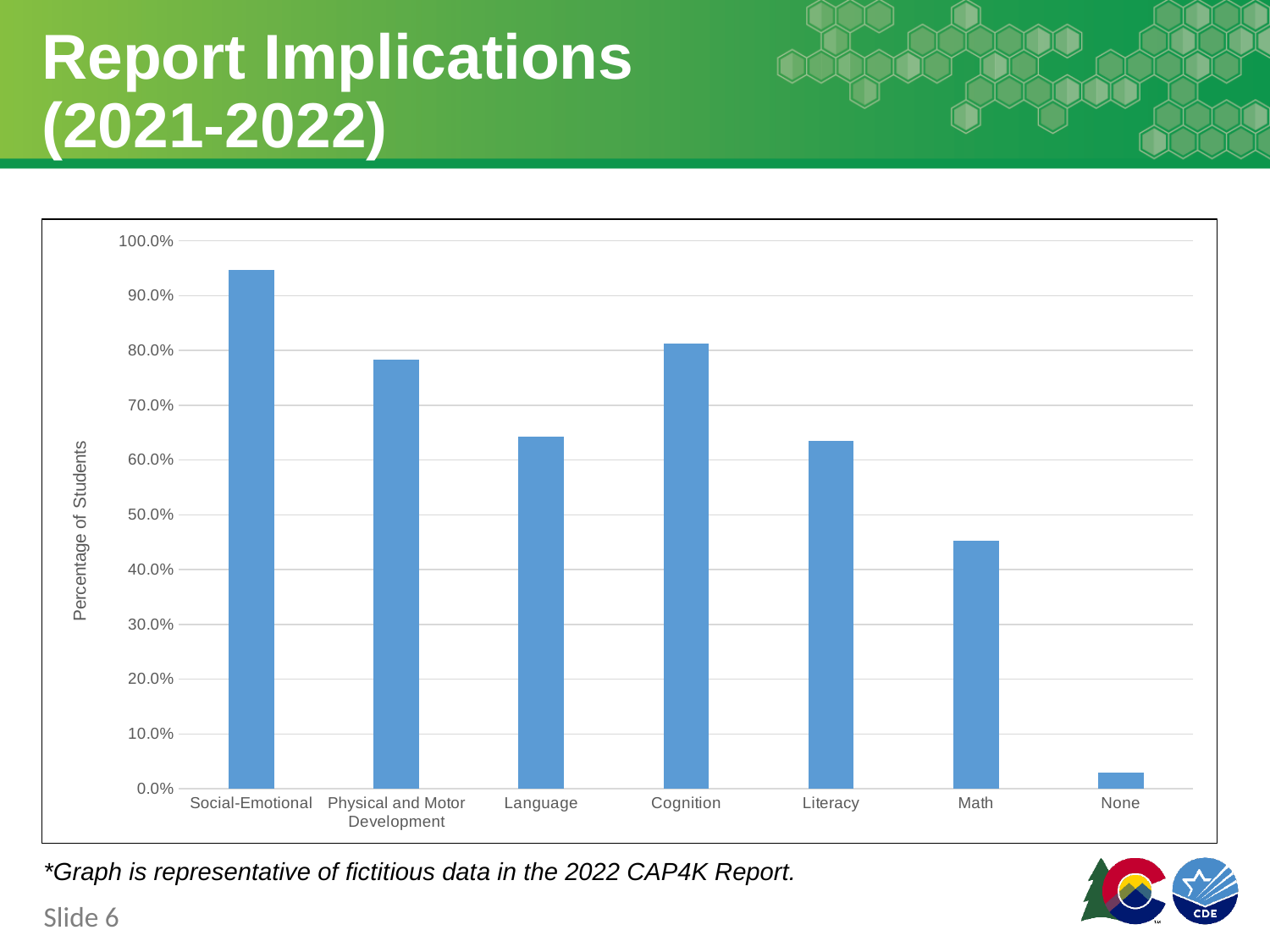
Is the value for Social-Emotional greater or less than 90.0%? greater Which category has the highest percentage of students? Social-Emotional Is the value for Cognition greater or less than 80.0%? greater Is the value for None greater or less than 10.0%? less Which has a higher percentage of students, Math or Language? Language Which category has the lowest percentage of students? None What is the label on the vertical axis of the chart? Percentage of Students Which has a higher percentage of students, Cognition or Physical and Motor Development? Cognition What kind of chart is shown on the slide? bar chart How many categories are shown on the x axis of the chart? 7